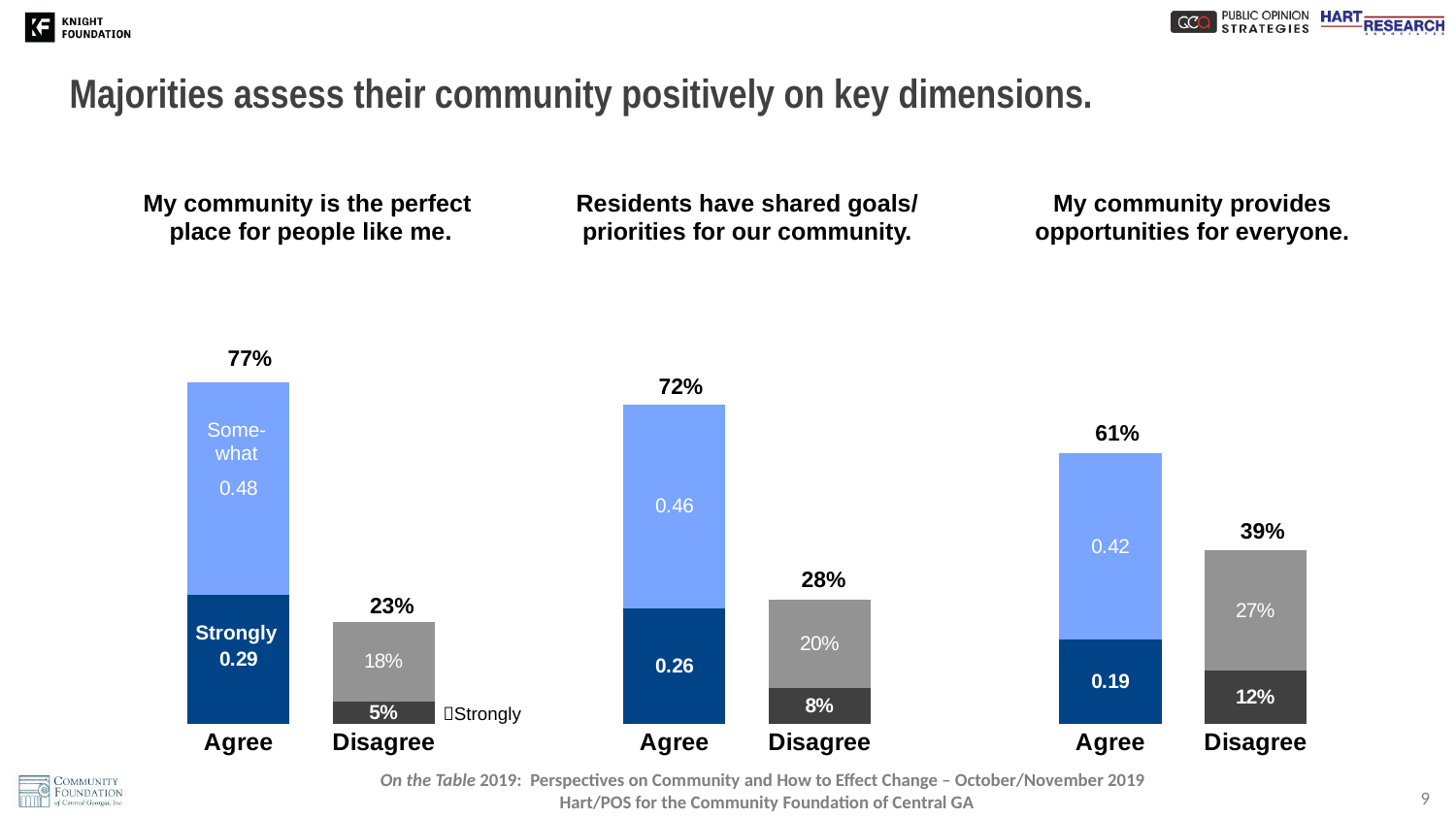
In the chart titled "My community is the perfect place for people like me," what value is printed in the Strongly segment of the Agree bar? 0.29 In the chart titled "My community provides opportunities for everyone," what value is printed in the Somewhat segment of the Disagree bar? 27% Across the three charts, which statement has the lowest Agree total? My community provides opportunities for everyone. In the chart titled "Residents have shared goals/priorities for our community," what value is printed in the Somewhat segment of the Agree bar? 0.46 In the chart titled "Residents have shared goals/priorities for our community," which bar is taller, Agree or Disagree? Agree Across the three charts, which statement has the highest Agree total? My community is the perfect place for people like me. In the chart titled "My community provides opportunities for everyone," what is the total percentage shown above the Agree bar? 61% In the chart titled "Residents have shared goals/priorities for our community," what is the total percentage shown above the Disagree bar? 28% In the chart titled "My community provides opportunities for everyone," what is the difference between the Agree total and the Disagree total? 22% In the chart titled "My community is the perfect place for people like me," what is the total percentage shown above the Agree bar? 77% What kind of chart is used on this slide? Stacked bar chart In the chart titled "My community is the perfect place for people like me," what value is printed in the Strongly segment of the Disagree bar? 5%